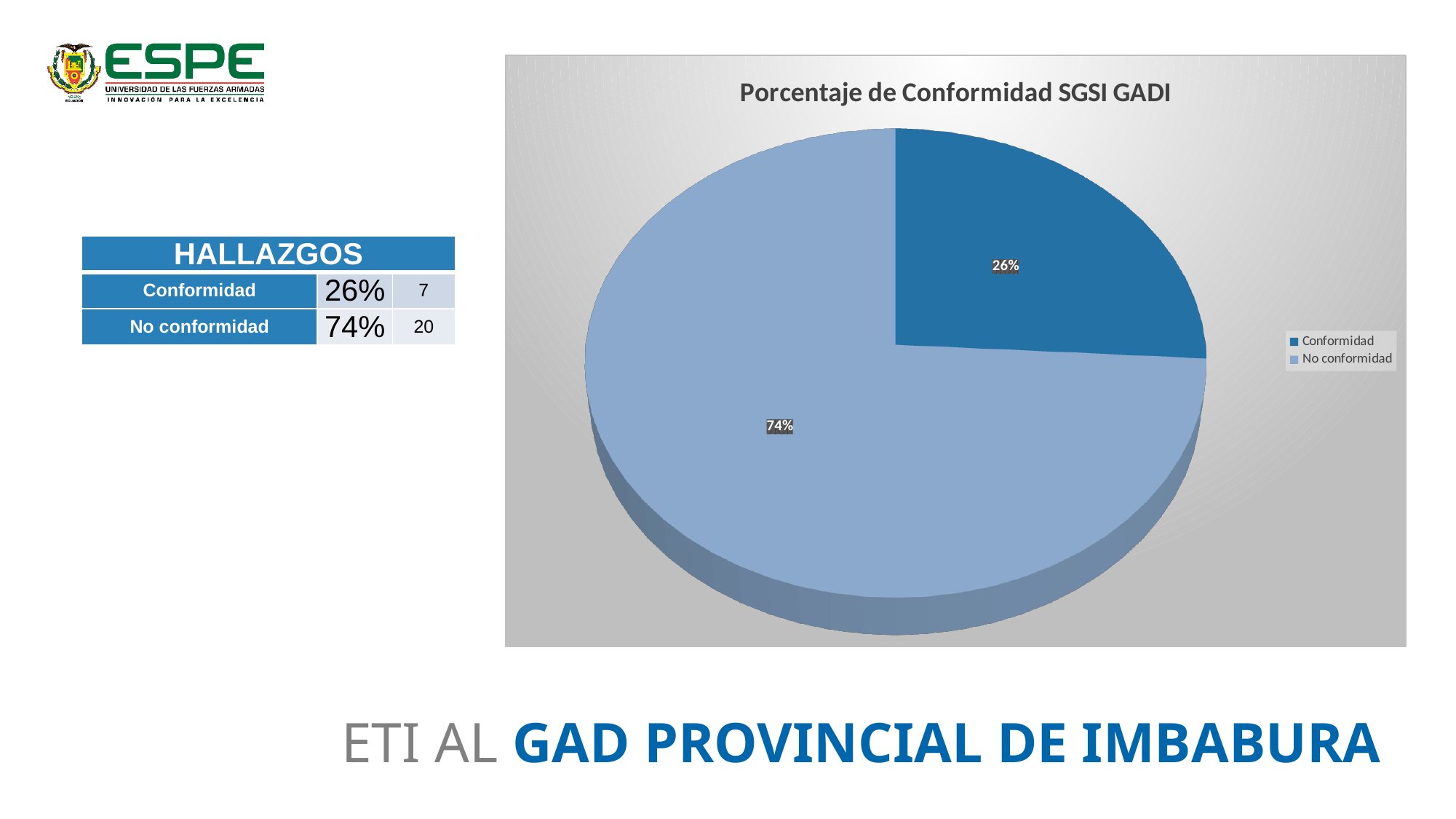
Which slice is the largest in the pie chart? No conformidad What type of chart is shown on the slide? Pie chart What share of the pie does the Conformidad slice represent? 26% What percentage does the Conformidad slice show? 26% What is the title of the chart? Porcentaje de Conformidad SGSI GADI How many entries does the legend list? 2 Which legend entry is shown in the darker blue colour? Conformidad Which is larger, the Conformidad slice or the No conformidad slice? No conformidad Which slice is the smallest in the pie chart? Conformidad What percentage does the No conformidad slice show? 74% What is the difference in percentage points between the No conformidad slice and the Conformidad slice? 48 How many slices does the pie chart have? 2